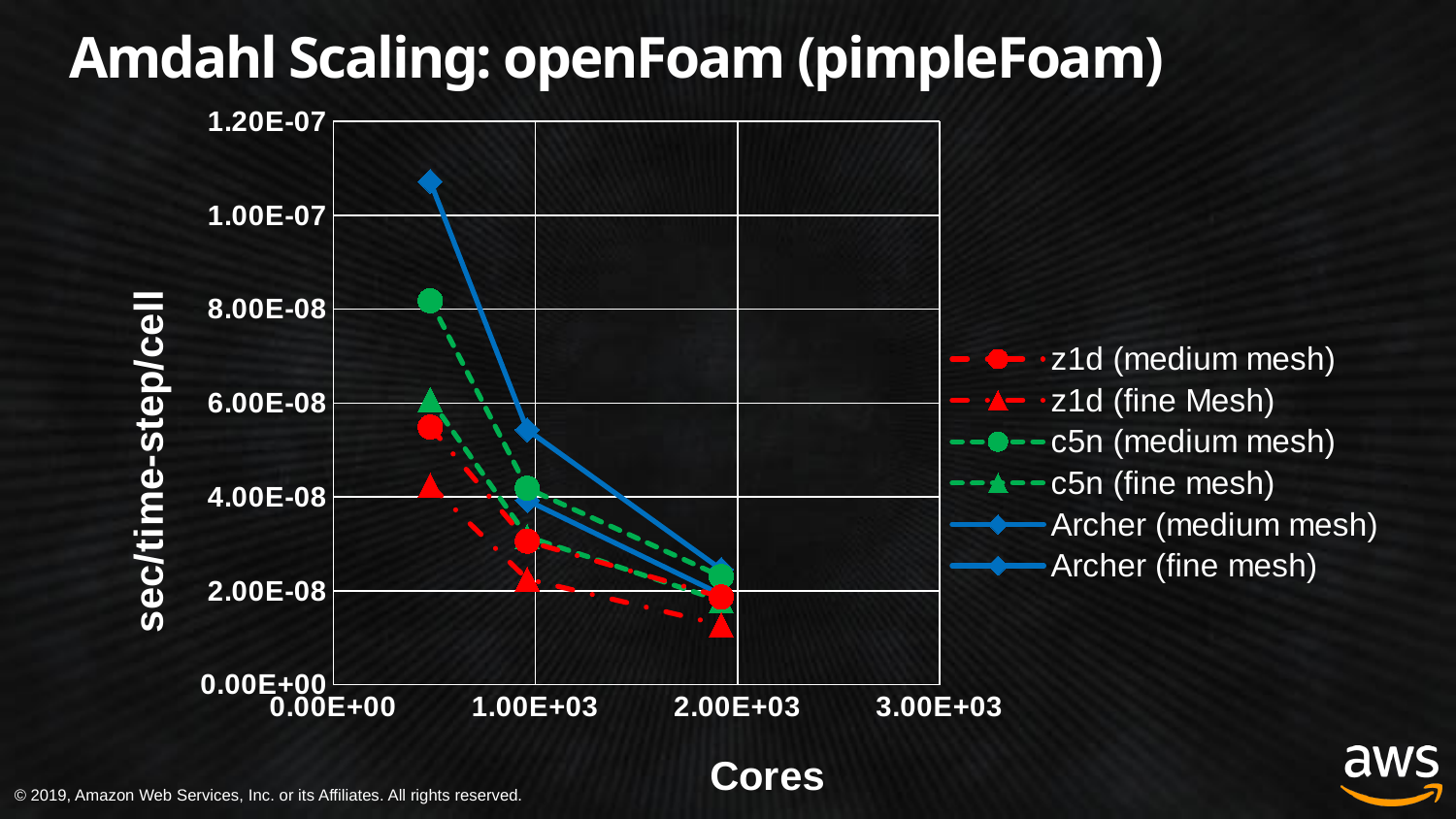
Is the first data point of z1d (medium mesh) greater or less than 6.00E-08? less How many series does the legend list? 6 At around 1.00E+03 cores, which is larger: c5n (medium mesh) or z1d (medium mesh)? c5n (medium mesh) Is the first data point of c5n (medium mesh) greater or less than 1.00E-07? less What kind of chart is shown on the slide? line chart Do the values for each series rise or fall as the number of cores increases? fall What is the label of the y axis? sec/time-step/cell What is the title of the chart? Amdahl Scaling: openFoam (pimpleFoam)